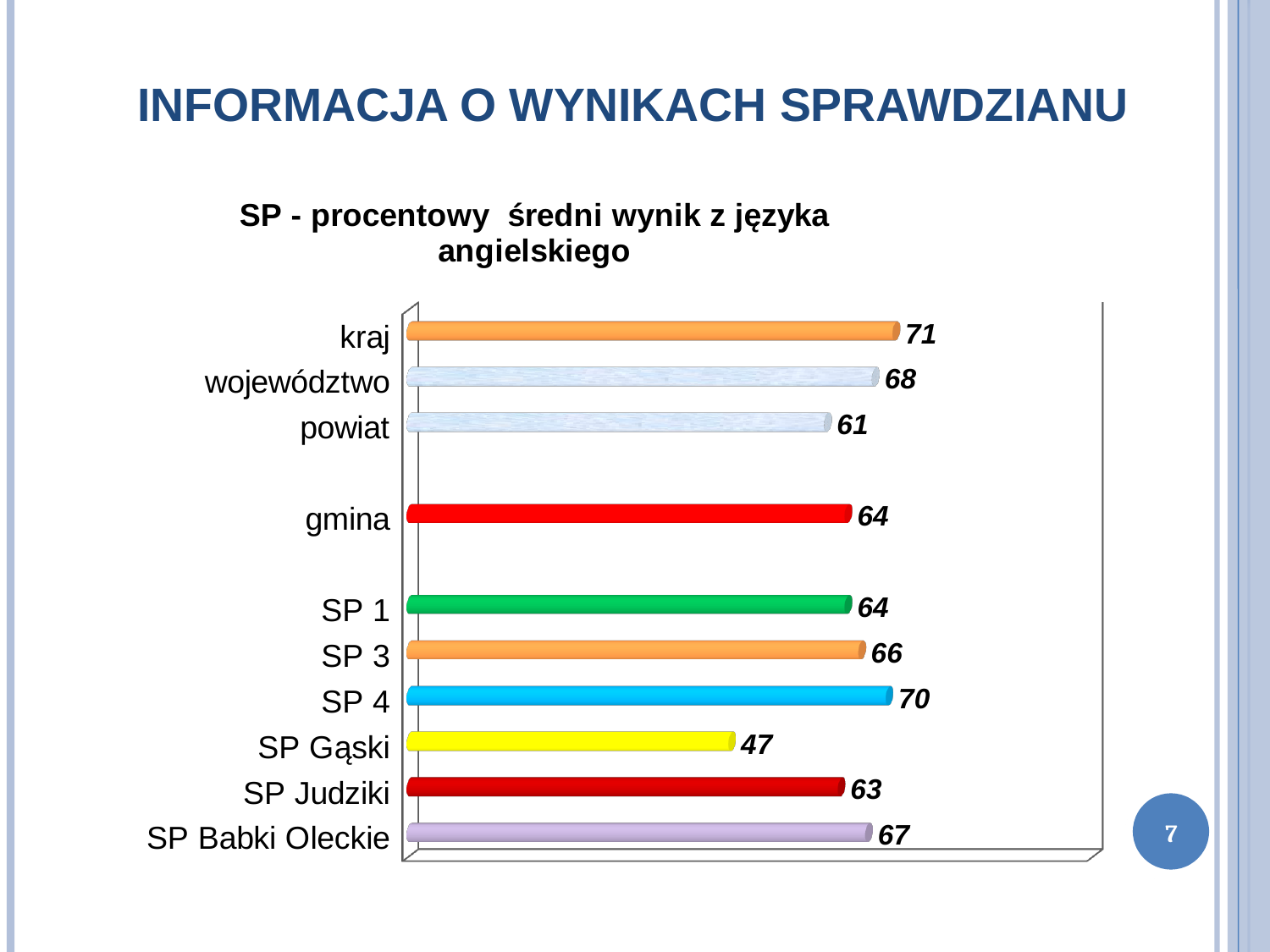
What kind of chart is shown on the slide? bar chart How many categories are shown in the chart? 10 What is the title of the chart? SP - procentowy średni wynik z języka angielskiego Which is larger, the value for SP 3 or the value for SP 1? SP 3 Which category has the lowest value? SP Gąski What is the difference between the values for kraj and SP Gąski? 24 What is the value for SP Babki Oleckie? 67 Which is larger, the value for województwo or the value for powiat? województwo What is the difference between the values for SP 4 and SP Judziki? 7 What is the value for SP Gąski? 47 What is the value for kraj? 71 Which category has the highest value? kraj